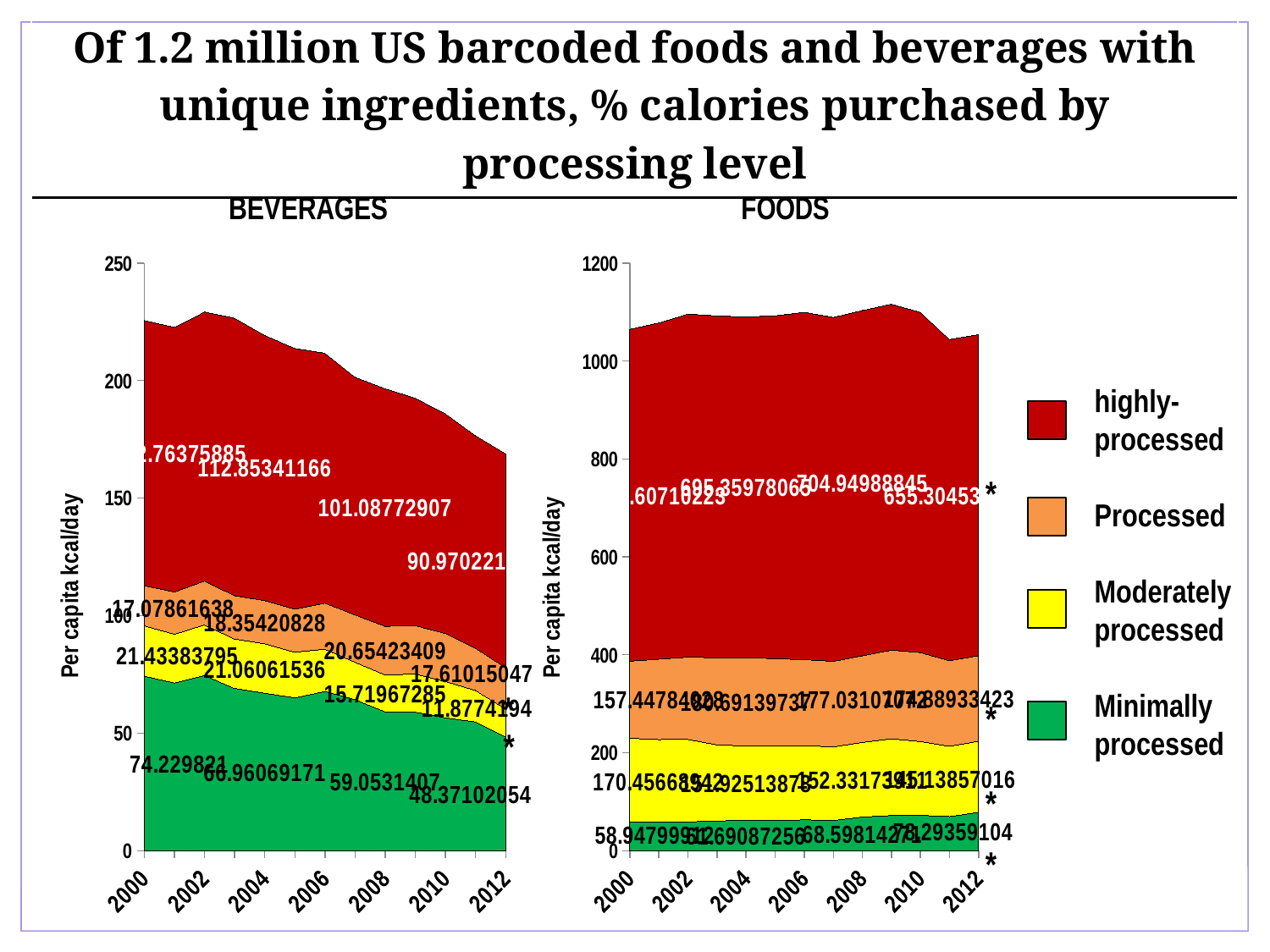
On the BEVERAGES chart in 2000, which is larger: the highly-processed band or the Minimally processed band? highly-processed What colour represents the highly-processed series in the legend? Red On the FOODS chart, what is the rightmost data label shown for the highly-processed series? 655.30453 What kind of chart is used for the BEVERAGES and FOODS panels on this slide? Stacked area chart On the BEVERAGES chart, what is the last (rightmost) data label shown for the Minimally processed series? 48.37102054 On the BEVERAGES chart, what is the difference between the first and last Minimally processed data labels (74.229821 and 48.37102054)? 25.85880046 On the BEVERAGES chart, what is the first (leftmost) data label shown for the Minimally processed series? 74.229821 On the BEVERAGES chart, does the total per capita kcal/day rise or fall from 2000 to 2012? Fall How many processing-level series does the legend list? 4 On the FOODS chart, what is the largest highly-processed data label printed? 704.94988845 On the BEVERAGES chart, is the total stacked value in 2000 greater or less than 200? greater On the FOODS chart, is the total stacked value in 2012 greater or less than 1000? greater